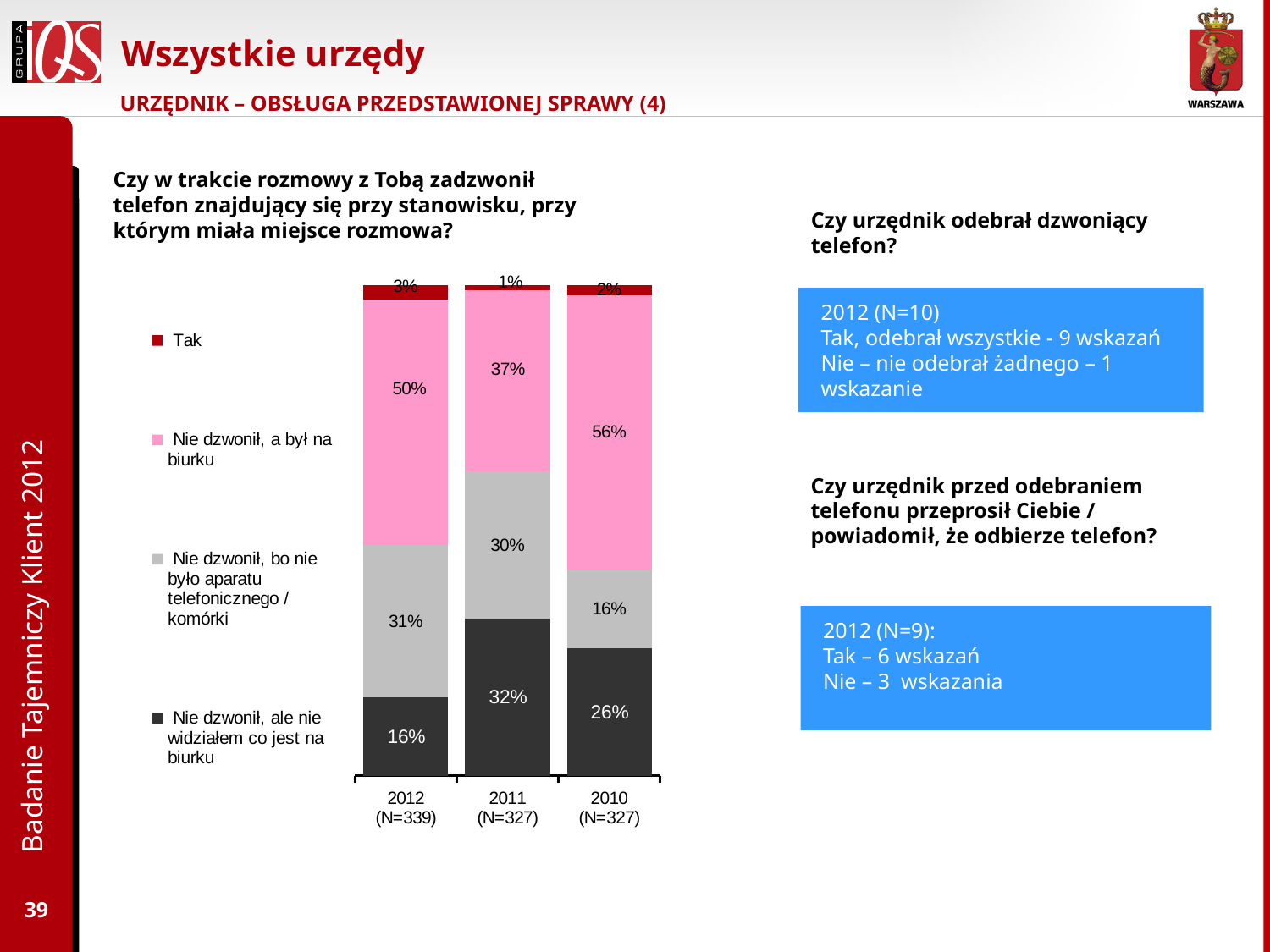
How many series does the chart legend list? 4 Which is larger: the 'Nie dzwonił, bo nie było aparatu telefonicznego / komórki' value in 2012 or in 2010? 2012 What is the value for 'Tak' in 2011? 1% What is the value for 'Nie dzwonił, ale nie widziałem co jest na biurku' in 2011? 32% What is the difference between the 'Nie dzwonił, a był na biurku' values for 2010 and 2011? 19 percentage points What is the value for 'Nie dzwonił, bo nie było aparatu telefonicznego / komórki' in 2010? 16% What type of chart is shown on the slide? stacked bar chart How many bars (years) are shown in the chart? 3 In which year is the value for 'Nie dzwonił, ale nie widziałem co jest na biurku' the lowest? 2012 What is the value for 'Nie dzwonił, a był na biurku' in 2012? 50% In which year is the value for 'Nie dzwonił, a był na biurku' the highest? 2010 What is the sample size (N) shown for the 2012 bar? N=339